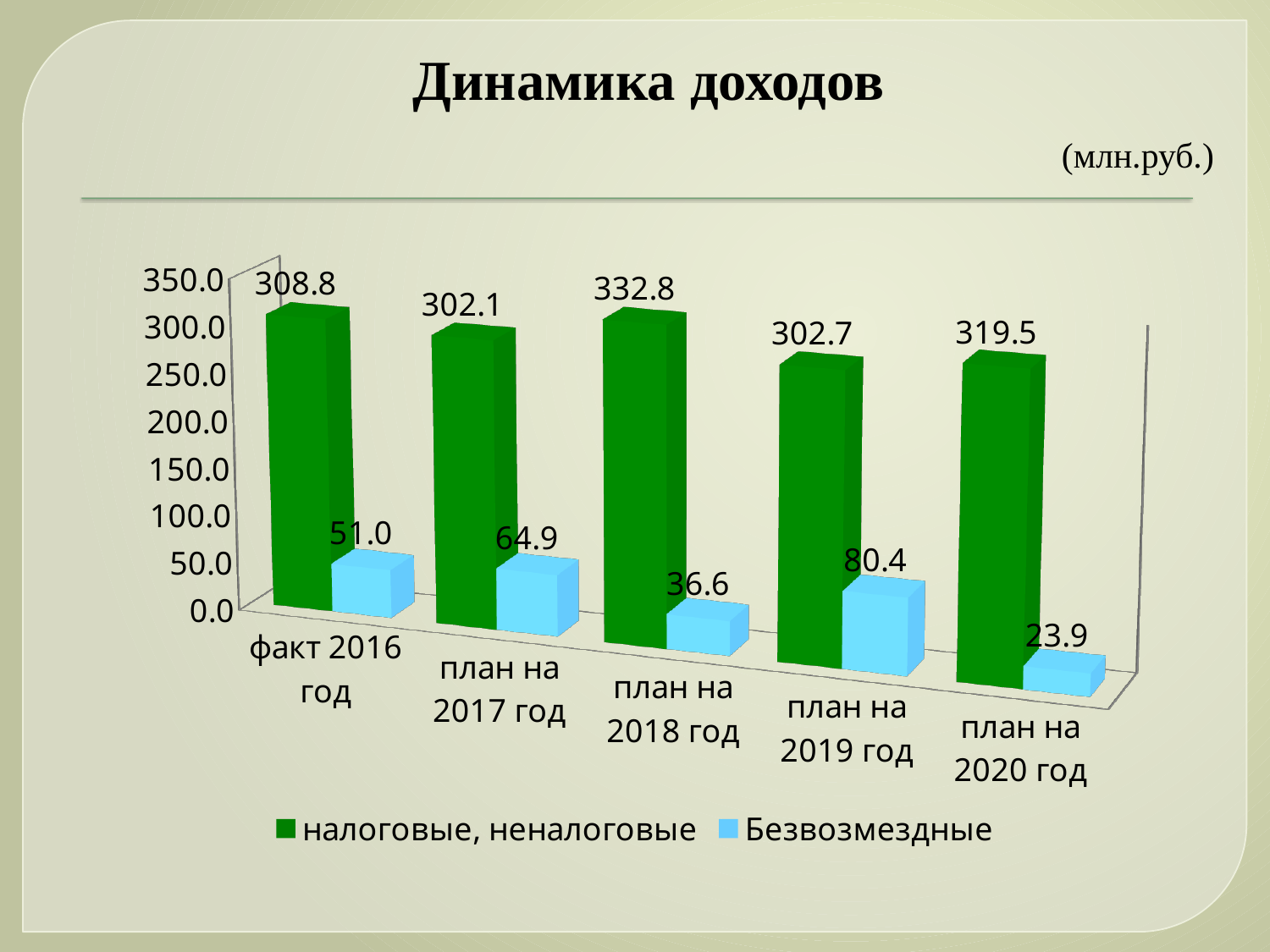
What is the value for налоговые, неналоговые for факт 2016 год? 308.8 What is the value for Безвозмездные for план на 2019 год? 80.4 What kind of chart is shown on the slide? bar chart Which category has the lowest value for Безвозмездные? план на 2020 год Is the value for налоговые, неналоговые for план на 2019 год greater or less than 300.0? greater What is the title of the chart? Динамика доходов What is the difference between the налоговые, неналоговые values for план на 2018 год and план на 2017 год? 30.7 How many series does the legend list? 2 Which is larger: the Безвозмездные value for план на 2017 год or for факт 2016 год? план на 2017 год How many categories are shown on the x axis? 5 Which category has the highest value for налоговые, неналоговые? план на 2018 год What is the value for налоговые, неналоговые for план на 2020 год? 319.5